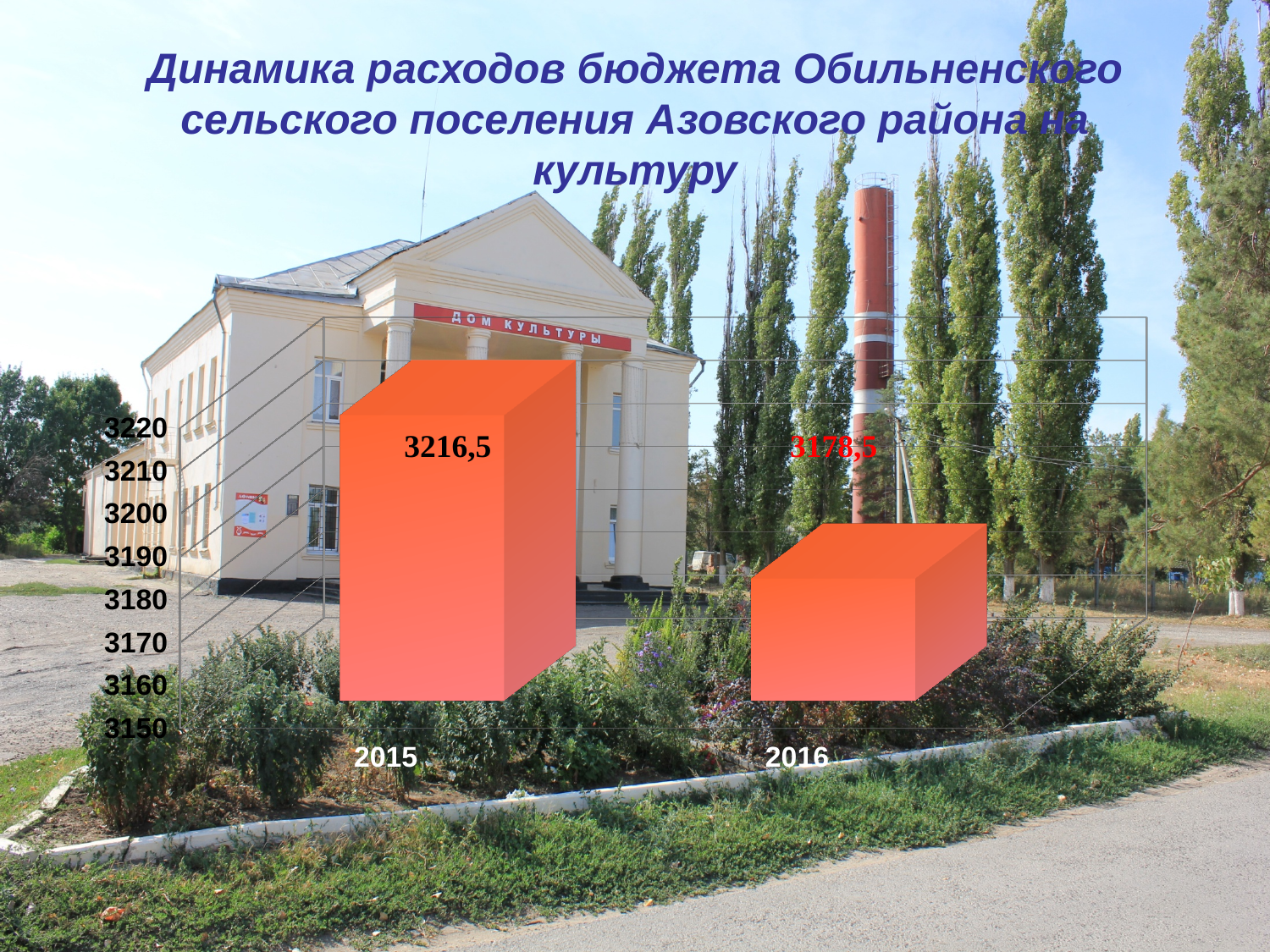
Is the value for 2015 greater or less than 3200? greater Which is larger, the value for 2015 or the value for 2016? 2015 How many years are shown on the chart? 2 What is the value for 2015? 3216,5 Which year has the highest value? 2015 Which year has the lowest value? 2016 What is the value for 2016? 3178,5 What is the difference between the values for 2015 and 2016? 38 What is the title of the slide? Динамика расходов бюджета Обильненского сельского поселения Азовского района на культуру Do the values rise or fall from 2015 to 2016? fall Is the value for 2016 greater or less than 3200? less What kind of chart is shown on the slide? bar chart